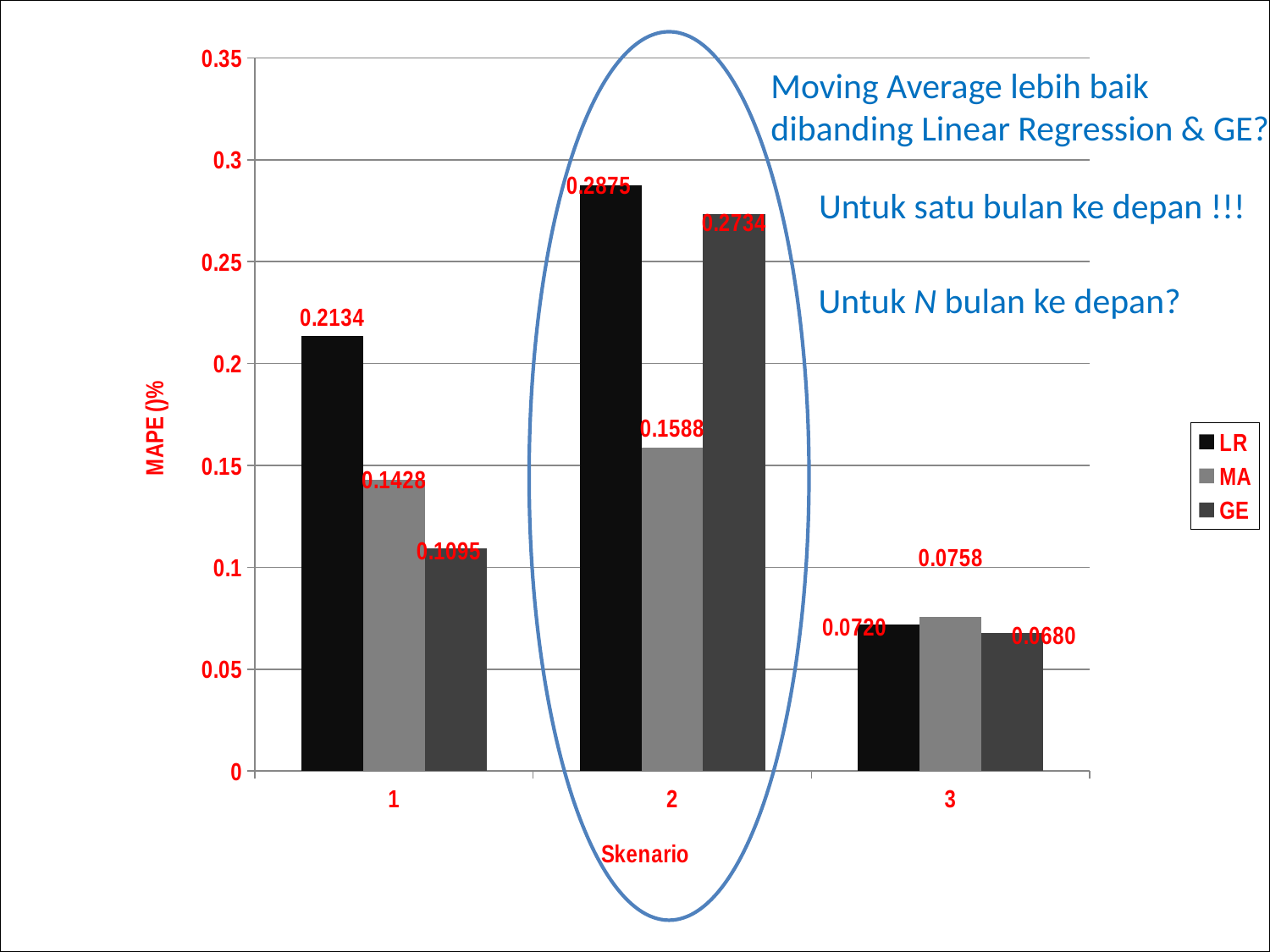
Which is larger in Skenario 1, the MA value or the GE value? MA In which Skenario does LR have its highest MAPE value? 2 What is the label of the y axis? MAPE ()% How many series does the legend list? 3 What is the MAPE value for MA in Skenario 2? 0.1588 How many Skenario categories are shown on the x axis? 3 What is the MAPE value for LR in Skenario 1? 0.2134 What is the difference between the LR and MA values in Skenario 2? 0.1287 What kind of chart is shown on the slide? bar chart Which series has the lowest MAPE value in Skenario 2? MA Is the GE value in Skenario 2 greater or less than 0.25? greater What is the MAPE value for GE in Skenario 3? 0.0680